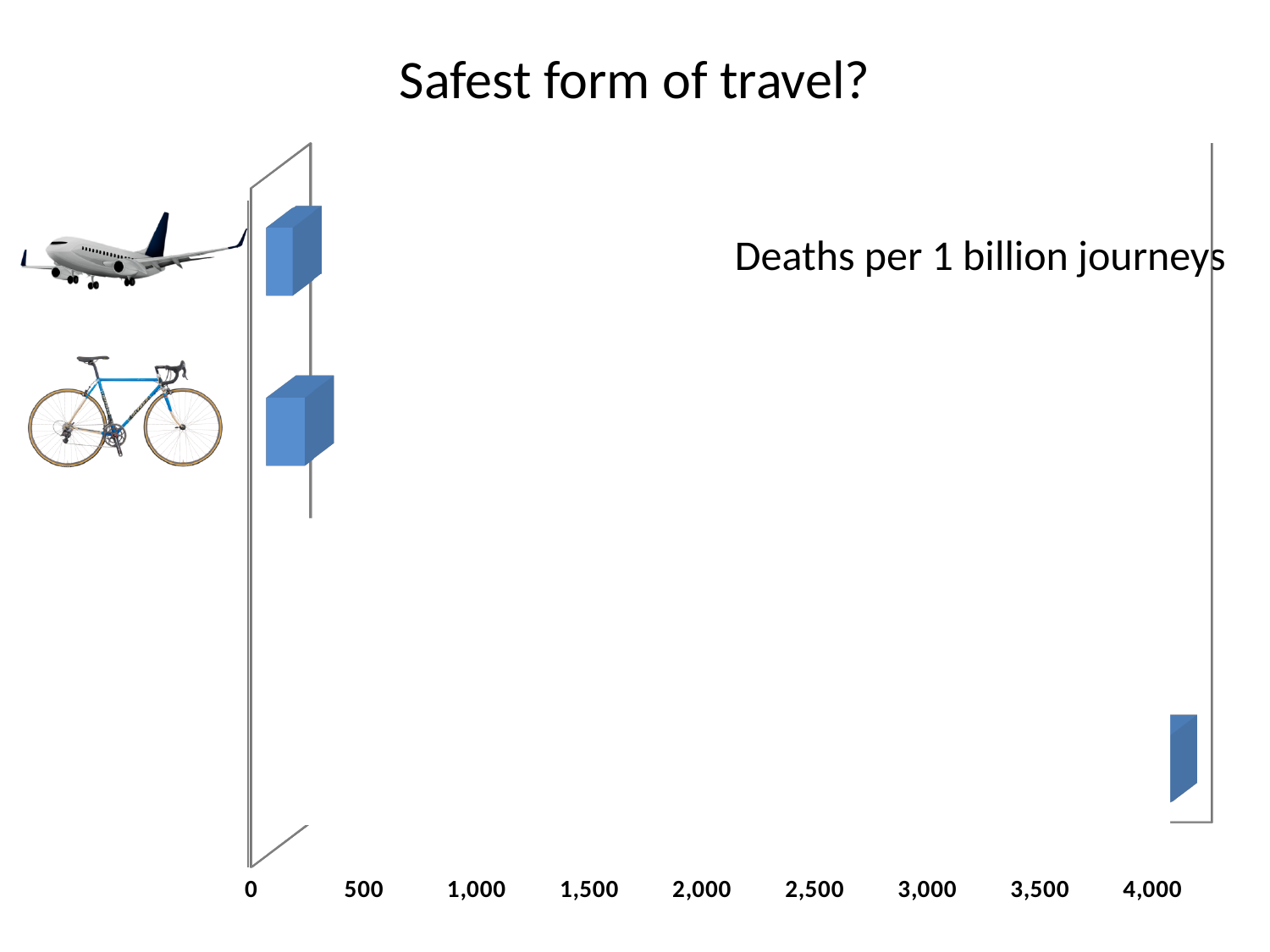
Is the value for the bottom bar greater or less than 1,000? greater Is the value for the bicycle bar greater or less than 500? less Is the value for the airplane bar greater or less than 1,000? less What is the highest tick label shown on the horizontal axis? 4,000 What kind of chart is shown on the slide? bar chart Which bar is the longest in the chart: the airplane bar or the bottom bar? the bottom bar How many bars are plotted in the chart? 3 What measure does the chart say the values represent? Deaths per 1 billion journeys